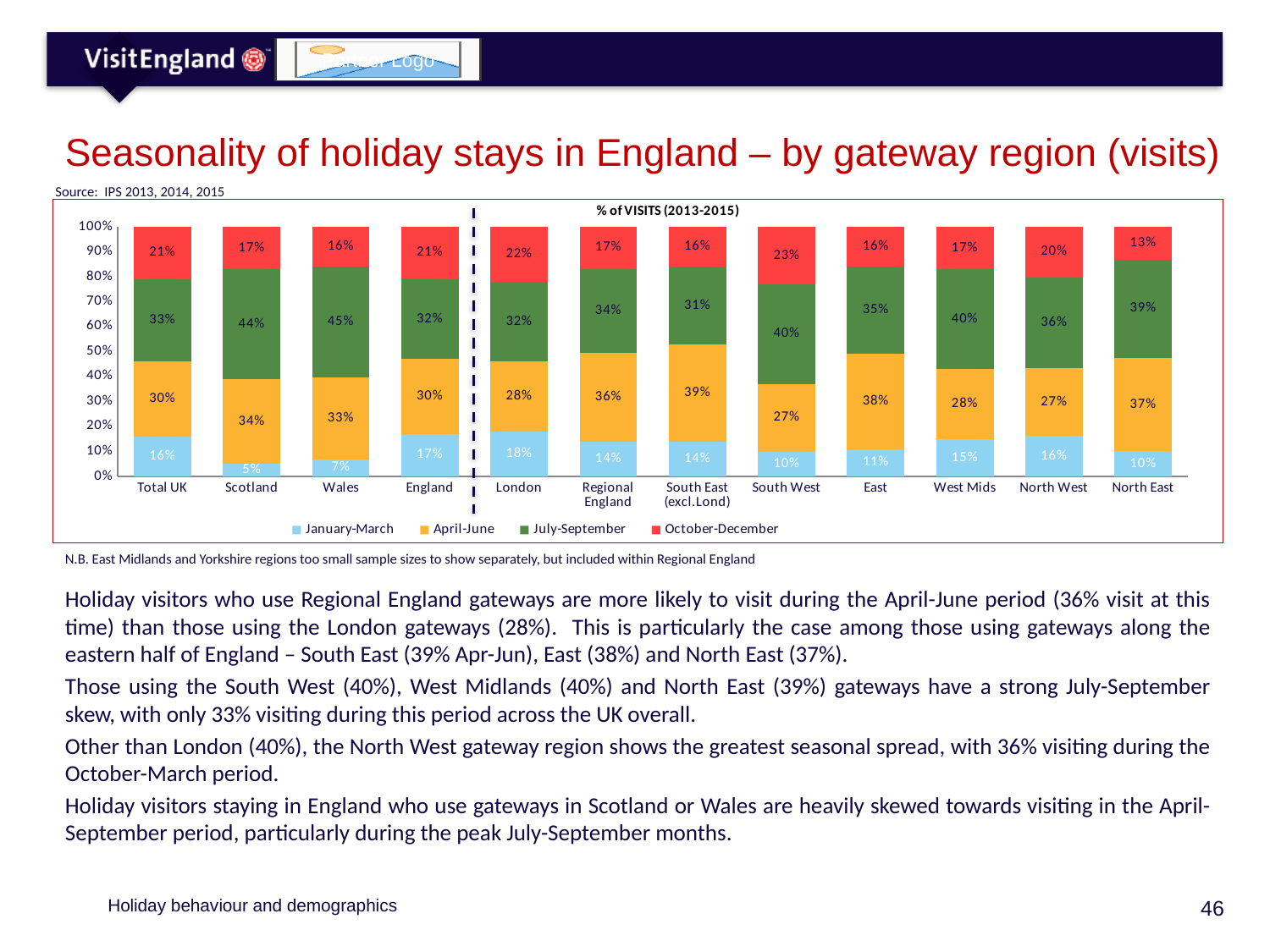
What kind of chart is shown on the slide? Stacked bar chart How many series does the legend list? 4 What is the January-March value for London? 18% What is the title shown above the chart? % of VISITS (2013-2015) What is the July-September value for South West? 40% Which gateway region has the lowest January-March value? Scotland What is the April-June value for Regional England? 36% What is the difference between the April-June values for South East (excl.Lond) and London? 11% How many gateway regions are shown on the x axis? 12 Which is larger, the October-December value for South West or for East? South West What is the October-December value for North East? 13% Which gateway region has the highest July-September value? Wales